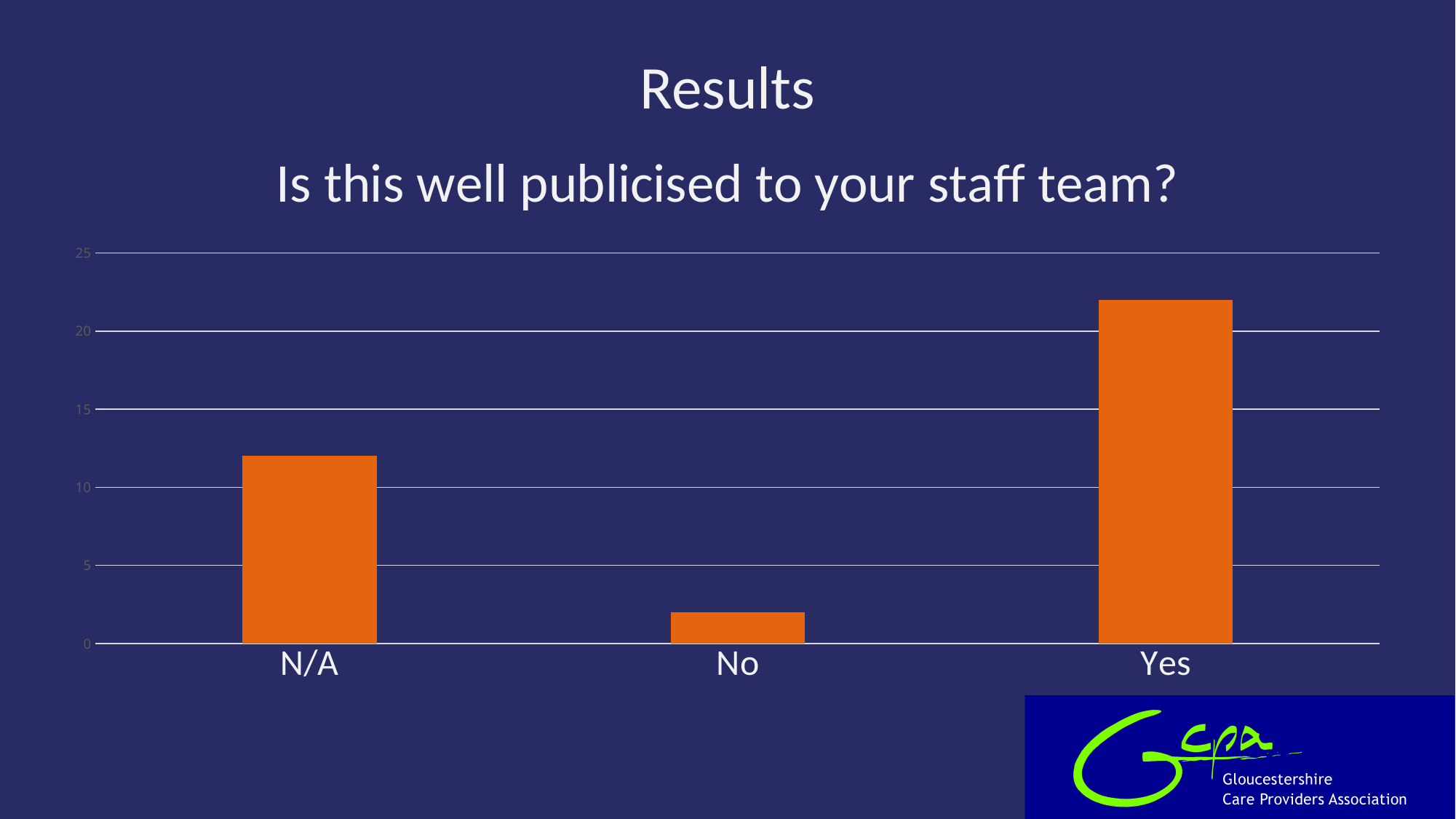
What is the highest value shown on the chart's vertical axis? 25 What kind of chart is shown on the slide? bar chart Which category has the highest bar in the chart? Yes Is the bar for Yes greater or less than 20? greater Is the bar for N/A greater or less than 15? less How many categories are shown on the x axis of the chart? 3 Which is larger, the bar for No or the bar for N/A? N/A Is the bar for N/A greater or less than 10? greater What question does the chart's title ask? Is this well publicised to your staff team? Which is larger, the bar for N/A or the bar for Yes? Yes Which category has the lowest bar in the chart? No